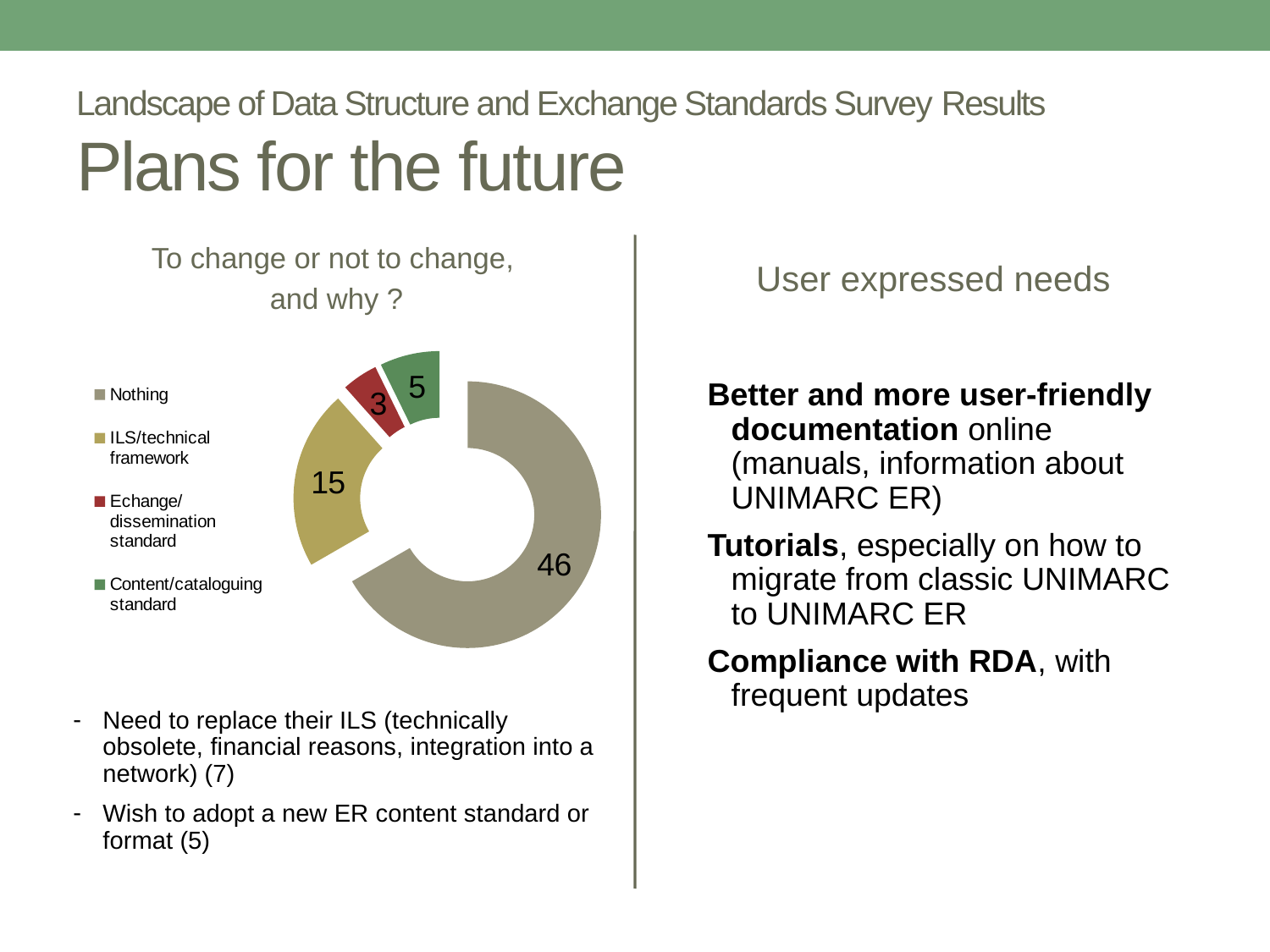
What is the difference between the 'Nothing' value and the 'ILS/technical framework' value? 31 What value is shown for 'ILS/technical framework' in the chart? 15 What value is shown for 'Content/cataloguing standard' in the chart? 5 Which is larger: the value for 'Content/cataloguing standard' or for 'Echange/dissemination standard'? Content/cataloguing standard What is the difference between the 'Content/cataloguing standard' value and the 'Echange/dissemination standard' value? 2 Which category has the smallest segment in the chart? Echange/dissemination standard What value is shown for the 'Nothing' segment in the 'To change or not to change, and why ?' chart? 46 How many categories does the chart's legend list? 4 What type of chart is shown on the slide? doughnut chart What value is shown for 'Echange/dissemination standard' in the chart? 3 Which category has the largest segment in the chart? Nothing What is the total of all the values shown in the chart? 69